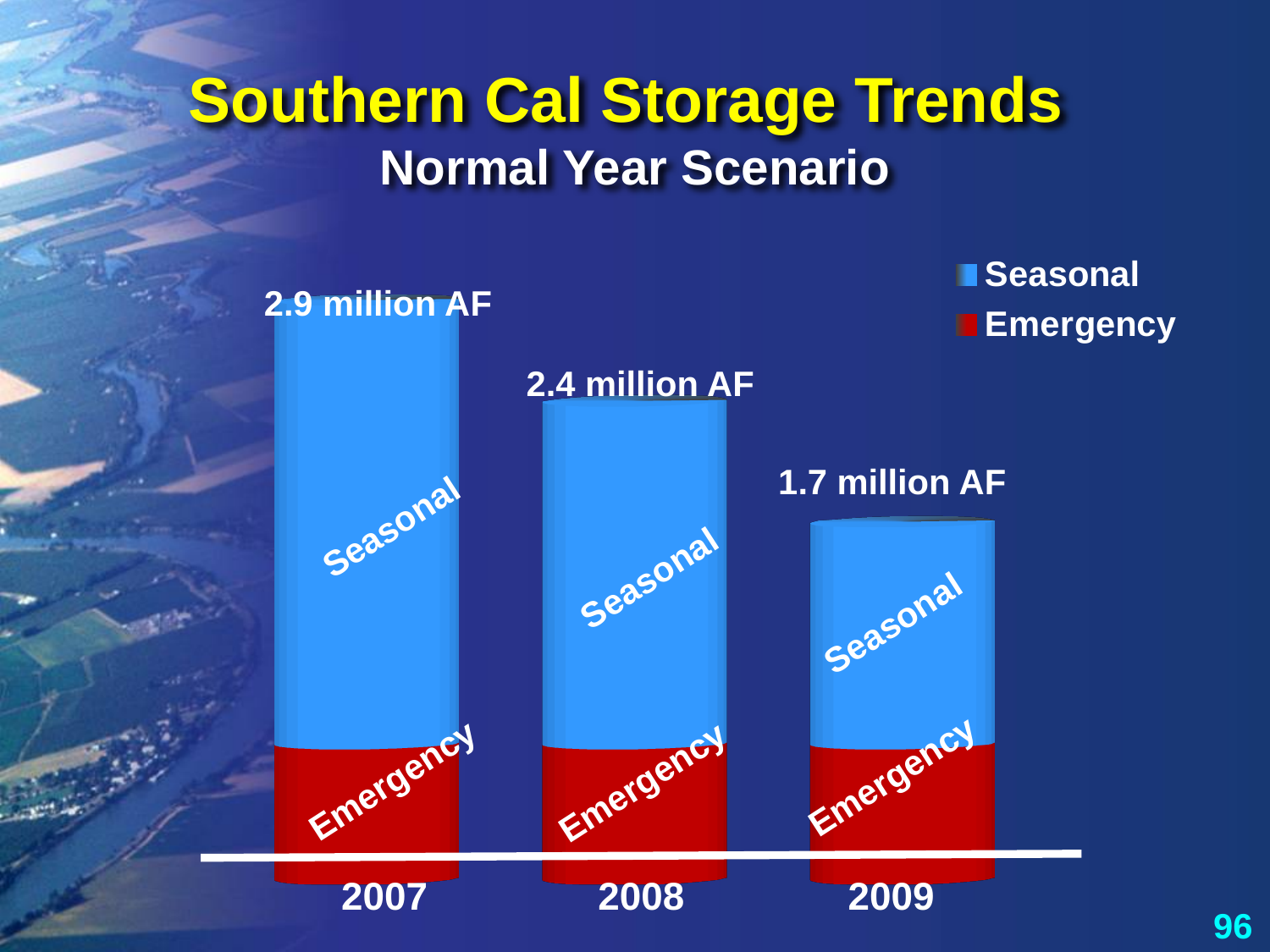
Which year has a larger total storage, 2008 or 2009? 2008 How many series does the legend list? 2 Do the total storage values rise or fall from 2007 to 2009? Fall What is the total storage shown for 2008? 2.4 million AF What is the total storage shown for 2009? 1.7 million AF What is the difference between the total storage in 2007 and 2009? 1.2 million AF How many years are shown on the chart? 3 What is the difference between the total storage in 2007 and 2008? 0.5 million AF What kind of chart is shown on the slide? Stacked bar chart Which year has the highest total storage? 2007 Which year has the lowest total storage? 2009 What is the total storage shown for 2007? 2.9 million AF